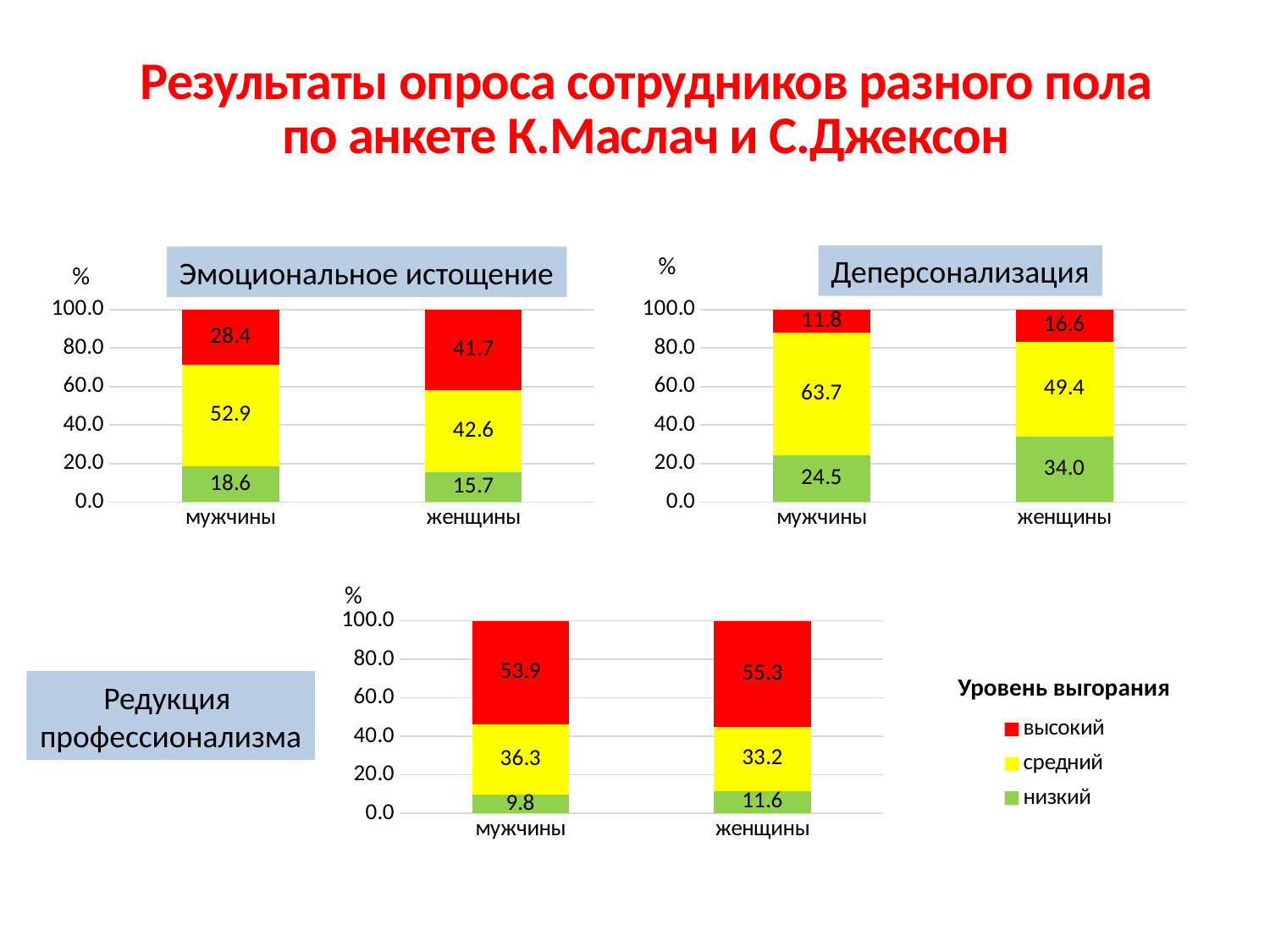
In the 'Эмоциональное истощение' chart, what is the value of the 'высокий' segment for мужчины? 28.4 In the 'Деперсонализация' chart, what is the difference between the 'средний' values for мужчины and женщины? 14.3 What kind of chart is the 'Деперсонализация' chart? Stacked bar chart In the 'Редукция профессионализма' chart, which category has the smaller 'низкий' value, мужчины or женщины? мужчины In the 'Деперсонализация' chart, what is the value of the 'низкий' segment for женщины? 34.0 How many categories are shown on the x axis of the 'Редукция профессионализма' chart? 2 In the 'Деперсонализация' chart, what is the total of the stacked bar for женщины? 100.0 In the 'Эмоциональное истощение' chart, what is the value of the 'средний' segment for женщины? 42.6 In the 'Редукция профессионализма' chart, what is the value of the 'высокий' segment for женщины? 55.3 How many series does the 'Уровень выгорания' legend list? 3 Which colour represents the 'средний' level in the legend? Yellow In the 'Эмоциональное истощение' chart, which category has the larger 'высокий' value, мужчины or женщины? женщины